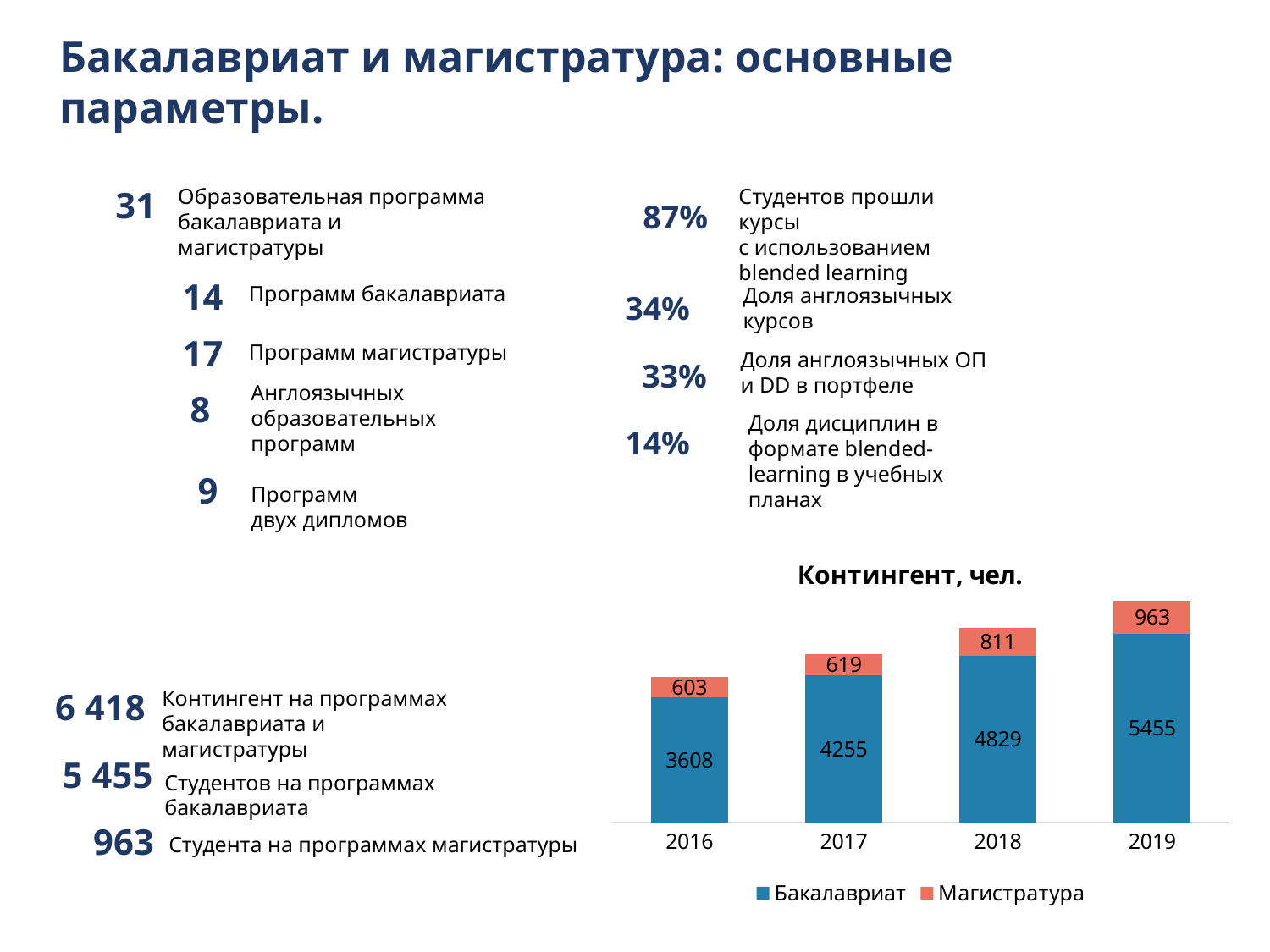
What is the total of the stacked bar for 2019? 6418 What is the value for Бакалавриат in 2017? 4255 In which year is the Магистратура value highest? 2019 What kind of chart is shown on the slide? Stacked bar chart Which is larger: the Магистратура value in 2017 or in 2016? 2017 How many years are shown on the x axis of the chart? 4 How many series does the chart legend list? 2 What is the value for Бакалавриат in 2016? 3608 What is the total of the stacked bar for 2016? 4211 What is the difference between the Бакалавриат values for 2019 and 2018? 626 What is the value for Магистратура in 2018? 811 In which year is the Бакалавриат value lowest? 2016